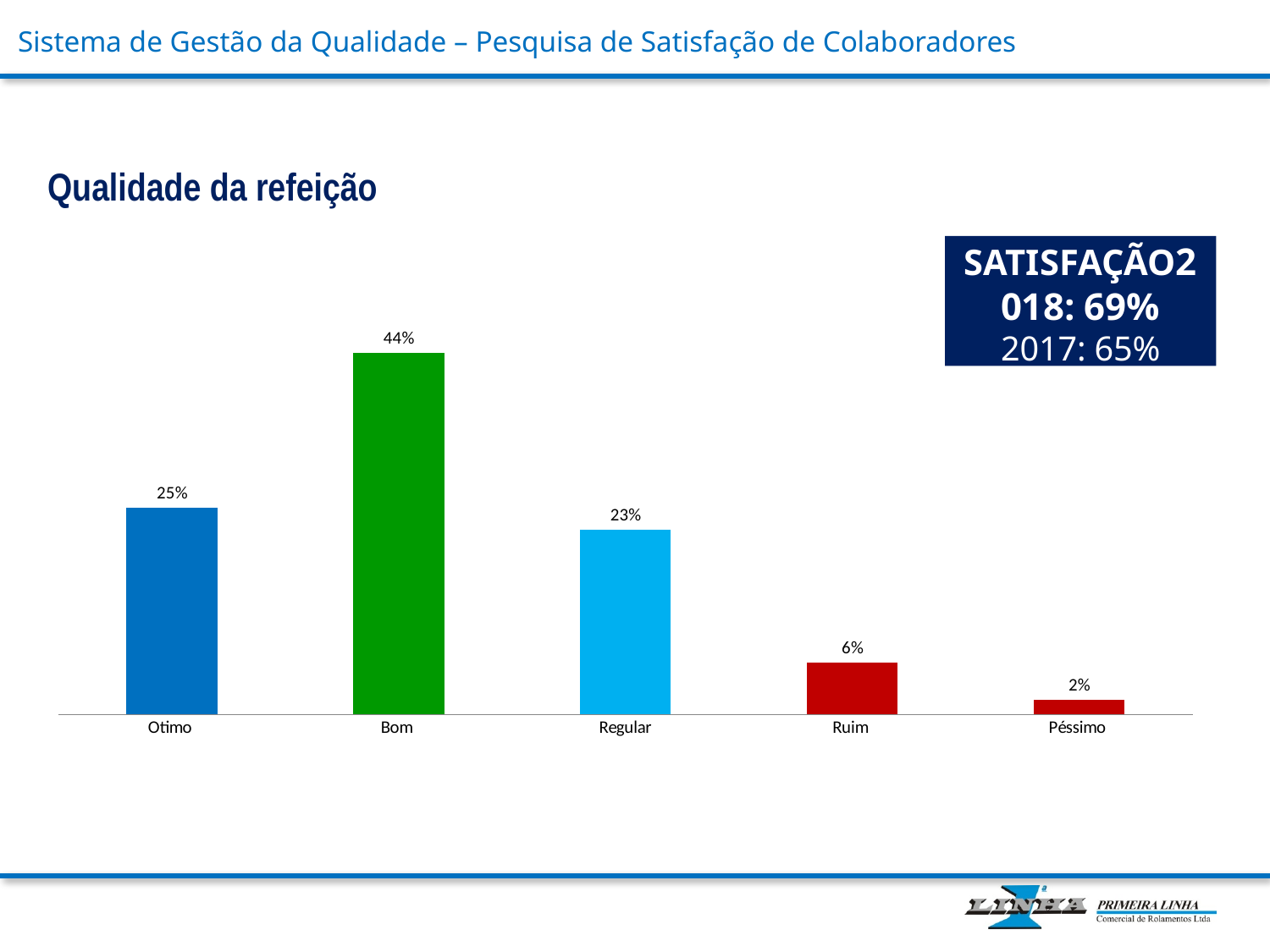
How many categories are shown on the x axis? 5 What is the value for Péssimo? 2% What is the value for Ruim? 6% What is the title of the chart? Qualidade da refeição Which category has the highest value? Bom What is the difference between the values for Bom and Otimo? 19% What kind of chart is shown on the slide? bar chart What is the value for Otimo? 25% Which is larger, the value for Otimo or the value for Regular? Otimo Which category has the lowest value? Péssimo What is the value for Regular? 23% What is the value for Bom? 44%